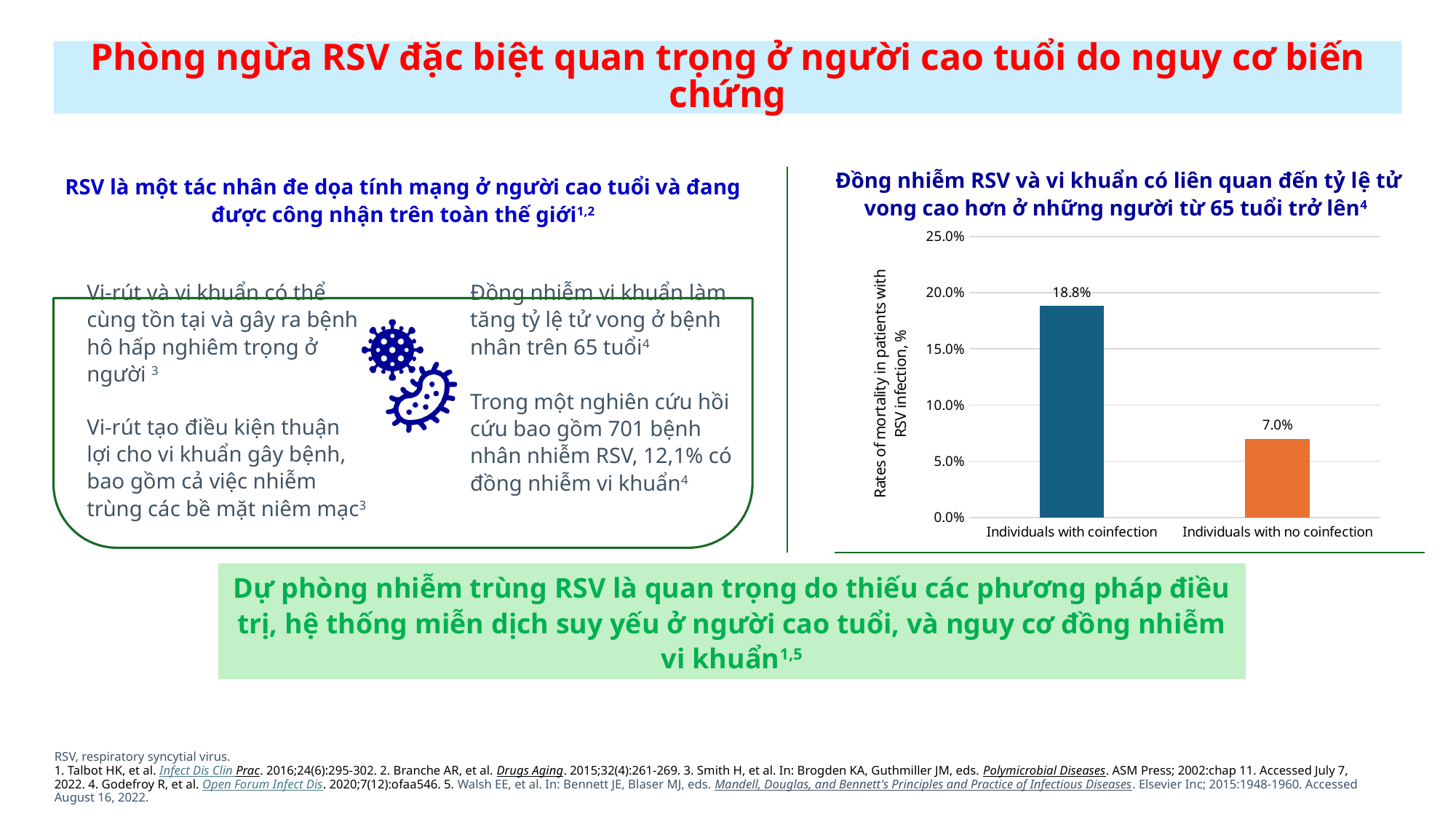
Is the value for individuals with coinfection greater or less than 15.0%? greater What is the mortality rate for individuals with coinfection? 18.8% How many categories are shown on the chart? 2 What is the maximum value shown on the vertical axis of the chart? 25.0% What is the difference in mortality rate between individuals with coinfection and individuals with no coinfection? 11.8% Which category has the higher mortality rate? Individuals with coinfection Is the value for individuals with no coinfection greater or less than 10.0%? less Which category has the lower mortality rate? Individuals with no coinfection What is the mortality rate for individuals with no coinfection? 7.0% Is the mortality rate higher for individuals with coinfection or for individuals with no coinfection? Individuals with coinfection What type of chart is shown on the slide? Bar chart What is the label of the vertical axis of the chart? Rates of mortality in patients with RSV infection, %